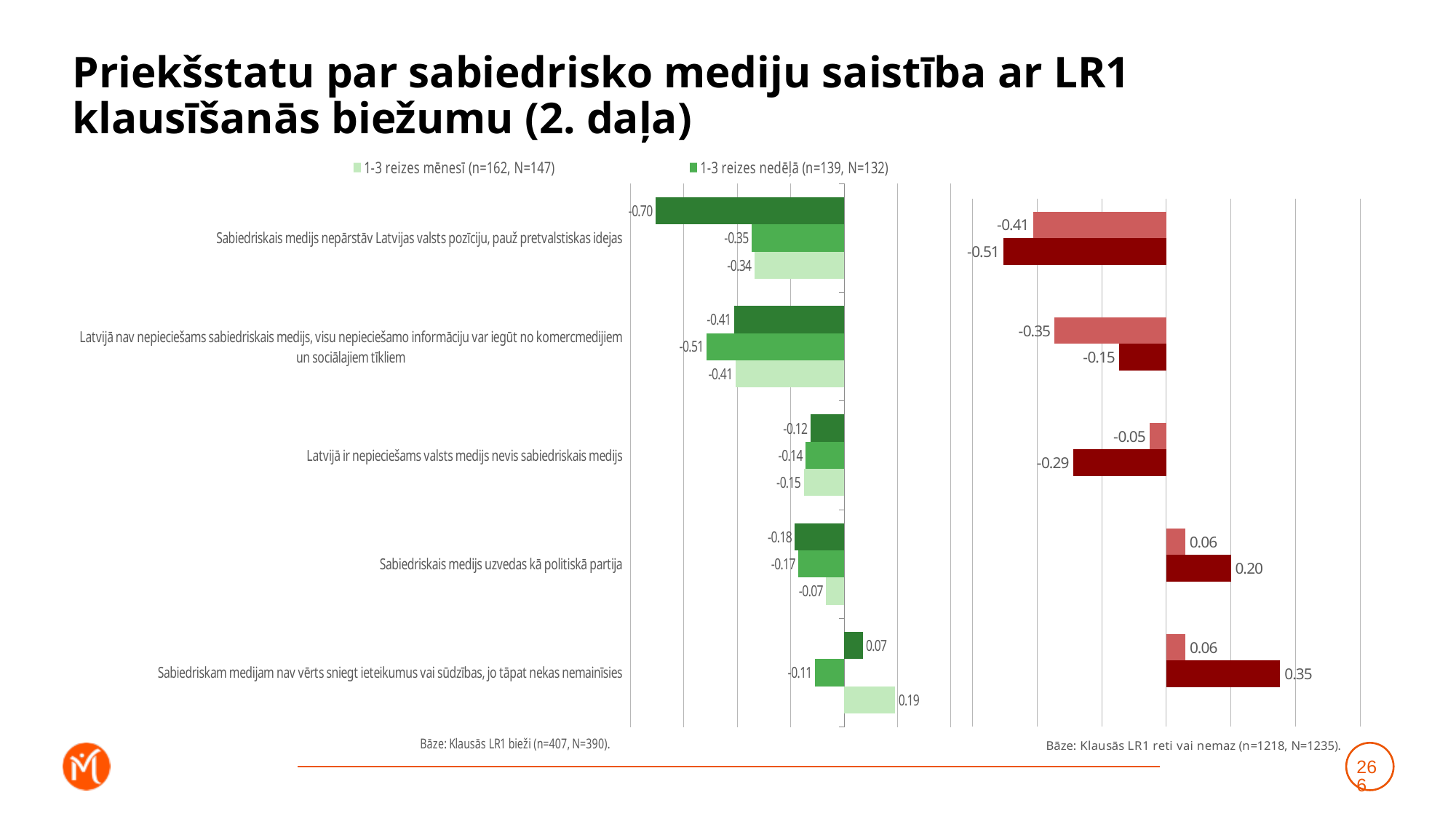
In the left (green) chart, what is the value of the '1-3 reizes mēnesī' series for 'Sabiedriskam medijam nav vērts sniegt ieteikumus vai sūdzības, jo tāpat nekas nemainīsies'? 0.19 In the left (green) chart, which statement has the lowest value across all bars? Sabiedriskais medijs nepārstāv Latvijas valsts pozīciju, pauž pretvalstiskas idejas In the right (red) chart, what is the difference between the dark red and light red values for 'Sabiedriskais medijs uzvedas kā politiskā partija'? 0.14 What is the base (Bāze) stated under the right (red) chart? Klausās LR1 reti vai nemaz (n=1218, N=1235) In the left (green) chart, what is the value of the '1-3 reizes nedēļā' series for 'Latvijā nav nepieciešams sabiedriskais medijs, visu nepieciešamo informāciju var iegūt no komercmedijiem un sociālajiem tīkliem'? -0.51 In the right (red) chart, what is the light red value for 'Latvijā ir nepieciešams valsts medijs nevis sabiedriskais medijs'? -0.05 In the left (green) chart, for 'Sabiedriskais medijs nepārstāv Latvijas valsts pozīciju, pauž pretvalstiskas idejas', which is larger: the '1-3 reizes mēnesī' value or the '1-3 reizes nedēļā' value? 1-3 reizes mēnesī In the right (red) chart, what is the dark red value for 'Sabiedriskam medijam nav vērts sniegt ieteikumus vai sūdzības, jo tāpat nekas nemainīsies'? 0.35 In the left (green) chart, what is the value of the '1-3 reizes mēnesī' series for 'Sabiedriskais medijs uzvedas kā politiskā partija'? -0.07 What type of chart is used on this slide? Bar chart In the right (red) chart, which statement has the highest dark red value? Sabiedriskam medijam nav vērts sniegt ieteikumus vai sūdzības, jo tāpat nekas nemainīsies How many statements (categories) are shown in the left (green) chart? 5